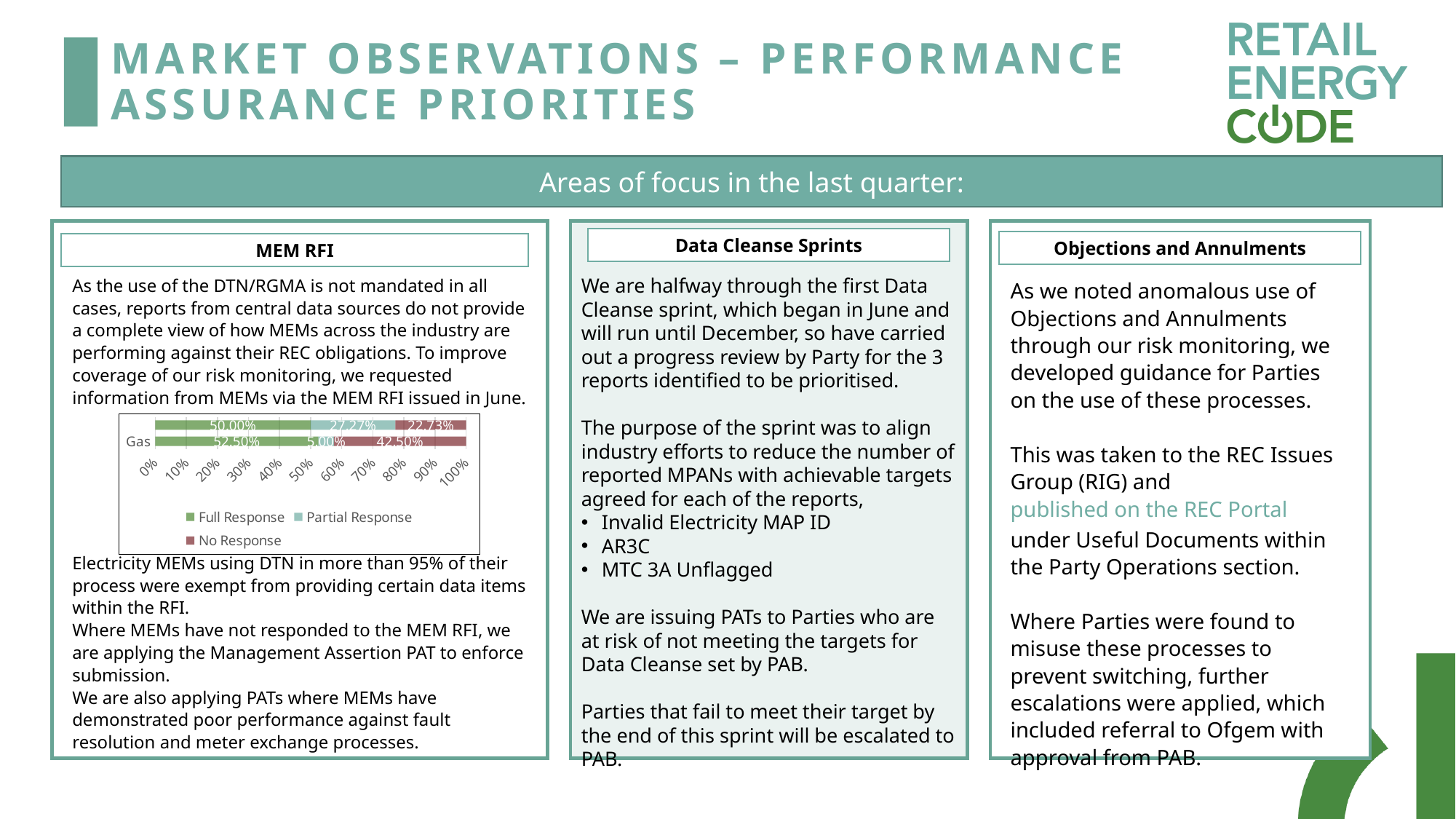
In the MEM RFI chart, what is the difference between the Full Response and No Response values for Gas? 10.00% In the MEM RFI chart, which is larger for Gas: Full Response or No Response? Full Response How many bars are plotted in the MEM RFI chart? 2 In the MEM RFI chart, what colour represents Full Response in the legend? green In the MEM RFI chart, what is the total of the Gas stacked bar? 100.00% In the MEM RFI chart, what is the Partial Response value for Gas? 5.00% In the MEM RFI chart, which response category has the smallest share for Gas? Partial Response In the MEM RFI chart, what is the No Response value for Gas? 42.50% How many series does the legend of the MEM RFI chart list? 3 In the MEM RFI chart, which response category has the largest share for Gas? Full Response In the MEM RFI chart, what is the Full Response value for Gas? 52.50% What kind of chart is shown in the MEM RFI section? bar chart